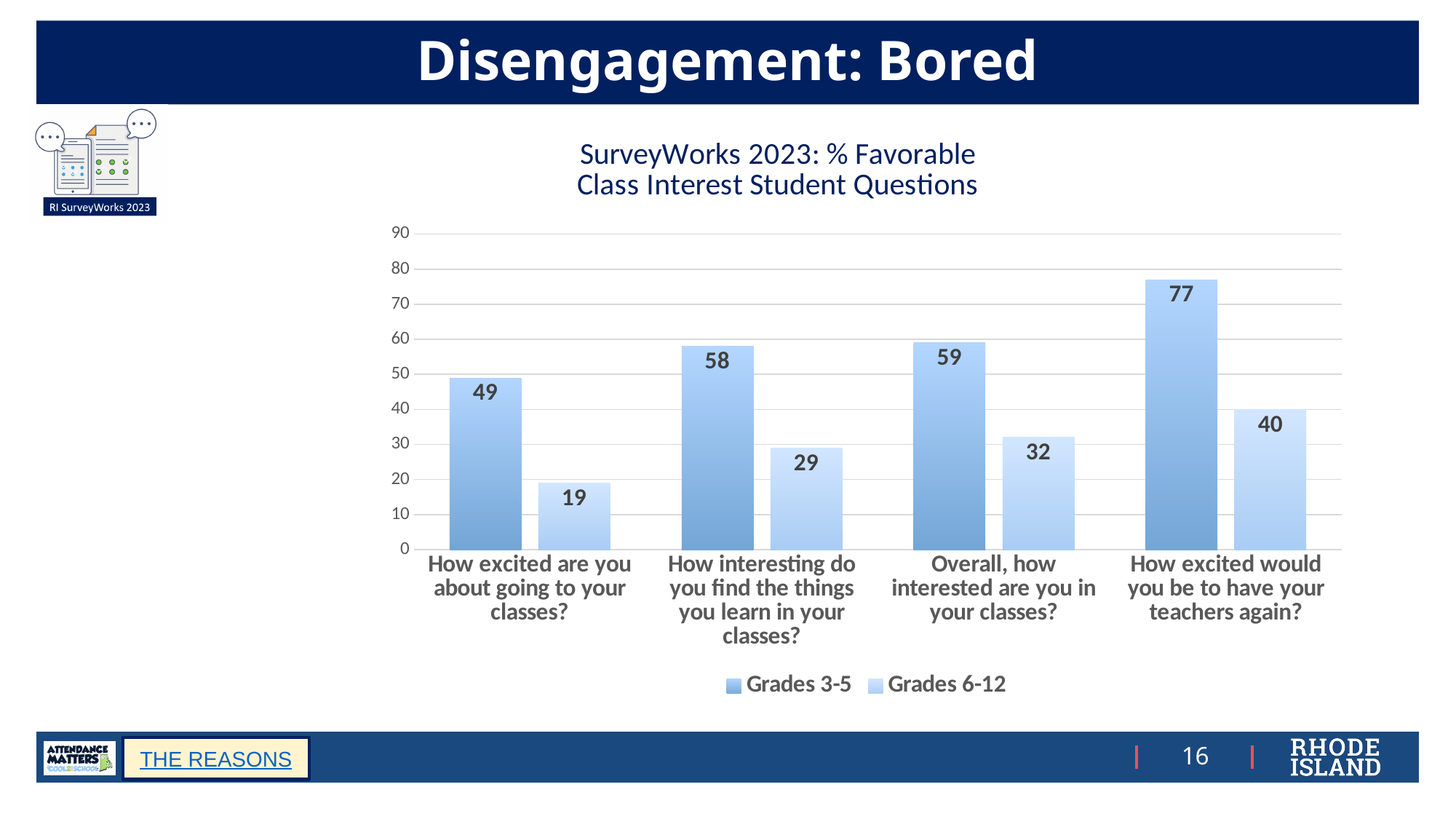
Is the Grades 3-5 value for "How excited would you be to have your teachers again?" greater or less than 70? greater Which is larger: the Grades 3-5 value for "How interesting do you find the things you learn in your classes?" or the Grades 3-5 value for "Overall, how interested are you in your classes?" Overall, how interested are you in your classes? What is the Grades 6-12 value for "How excited would you be to have your teachers again?" 40 Which question has the lowest Grades 6-12 value? How excited are you about going to your classes? How many series does the legend list? 2 What is the difference between the Grades 3-5 and Grades 6-12 values for "Overall, how interested are you in your classes?" 27 What kind of chart is shown on the slide? Bar chart Which question has the highest Grades 3-5 value? How excited would you be to have your teachers again? What is the Grades 6-12 value for "How interesting do you find the things you learn in your classes?" 29 What is the Grades 3-5 value for "How excited are you about going to your classes?" 49 How many survey questions (categories) are shown on the x axis? 4 What is the title of the chart? SurveyWorks 2023: % Favorable Class Interest Student Questions